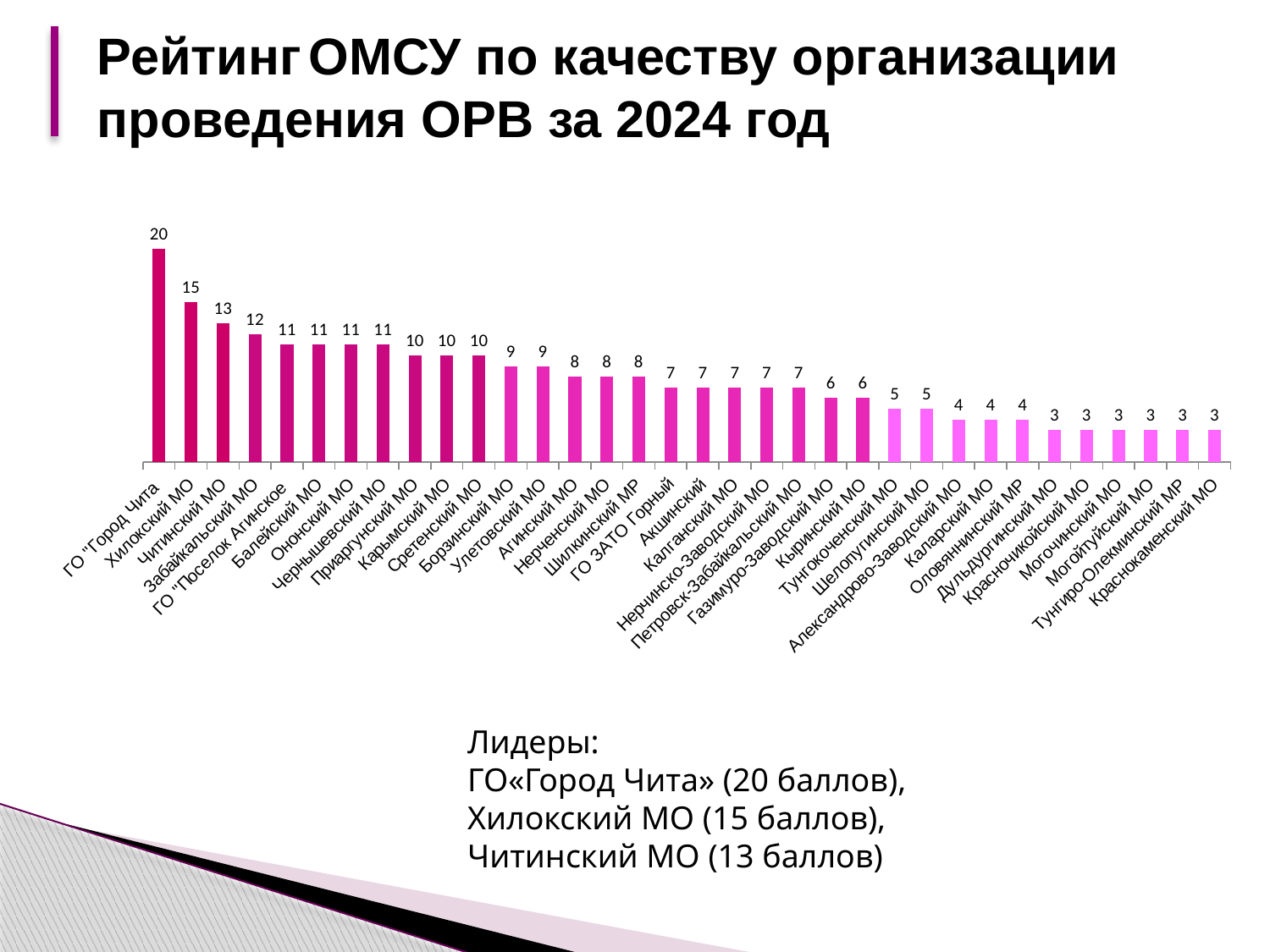
What value is shown for Шилкинский МР? 8 Which category has the highest value? ГО "Город Чита" What is the difference between the values for Хилокский МО and Тунгокоченский МО? 10 Do the values rise or fall from left to right along the x axis? Fall Which is larger, the value for Борзинский МО or the value for Акшинский? Борзинский МО What kind of chart is shown on the slide? Bar chart What value is shown for Каларский МО? 4 What value is shown for Забайкальский МО? 12 What is the difference between the values for ГО "Город Чита" and Читинский МО? 7 What value is shown for Кыринский МО? 6 How many categories are plotted in the chart? 34 What value is shown for Хилокский МО? 15